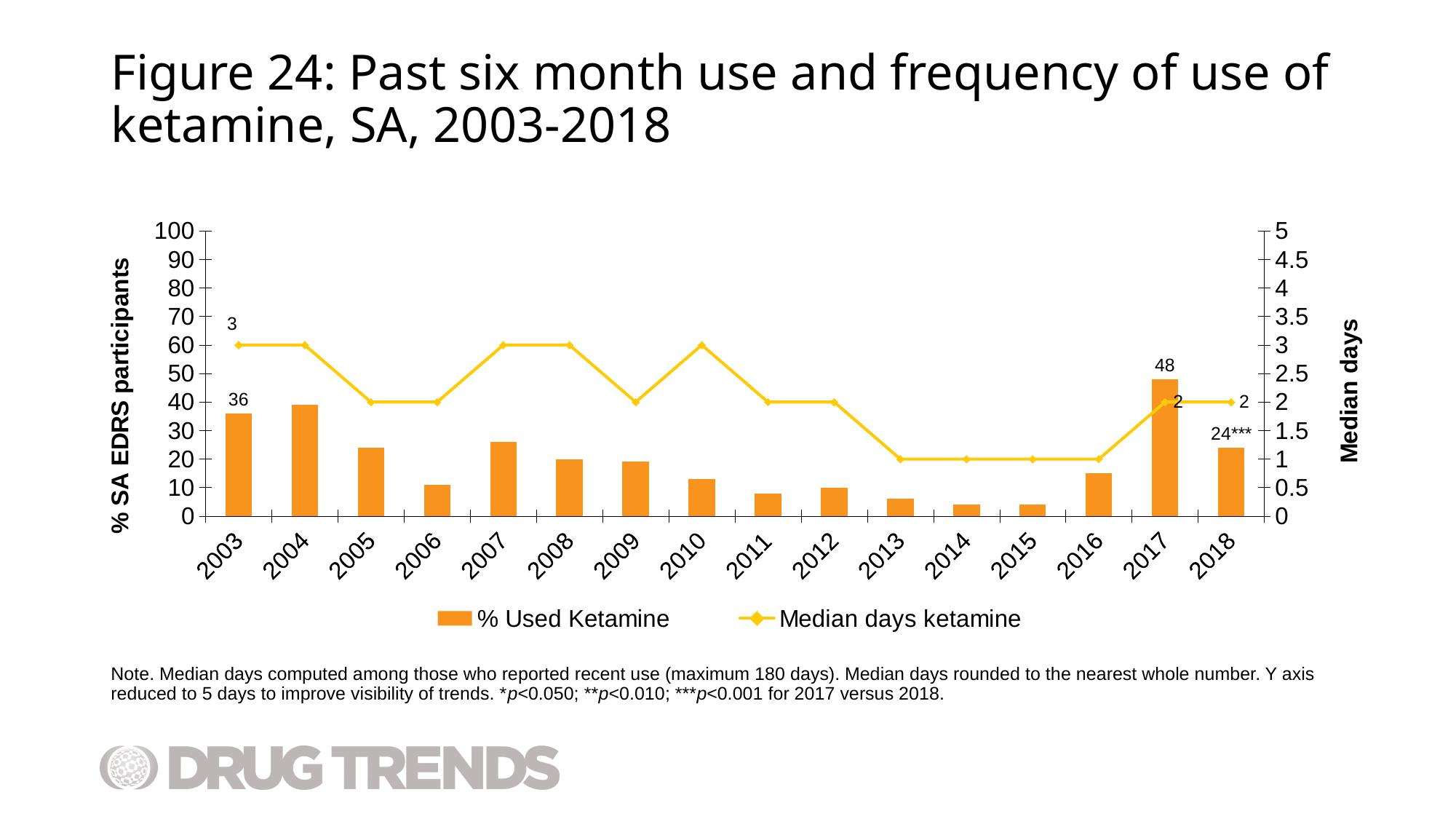
What kind of chart is this? Combined bar and line chart What is the value for % Used Ketamine in 2017? 48 Which year has a higher % Used Ketamine, 2004 or 2005? 2004 By how many percentage points did % Used Ketamine fall from 2017 to 2018? 24 How many years are shown on the x axis? 16 Which year has the highest % Used Ketamine? 2017 What is the data label shown on the % Used Ketamine bar for 2018? 24*** What was the median days of ketamine use in 2018? 2 What percentage of SA EDRS participants used ketamine in 2003? 36 How many series does the legend list? 2 What was the median days of ketamine use in 2003? 3 Is the % Used Ketamine value for 2006 greater or less than 20? less